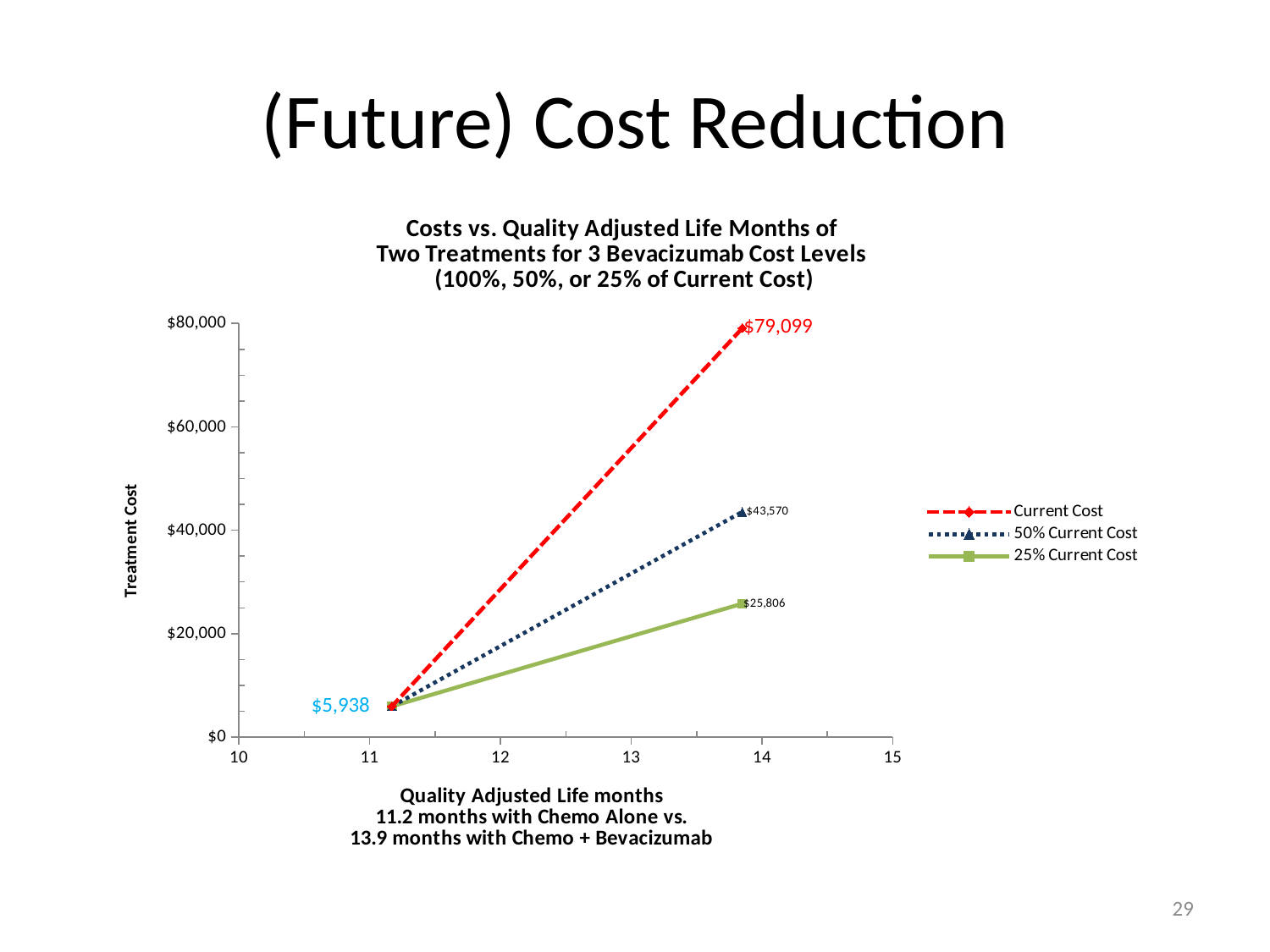
How many series does the legend list? 3 Which is larger at 13.9 months: the 50% Current Cost value or the 25% Current Cost value? 50% Current Cost Which series has the highest treatment cost at 13.9 months? Current Cost What is the treatment cost at 13.9 months for the Current Cost series? $79,099 What is the difference between the Current Cost and 50% Current Cost values at 13.9 months? $35,529 What kind of chart is shown on the slide? Line chart What is the difference between the 50% Current Cost and 25% Current Cost values at 13.9 months? $17,764 Do the treatment costs rise or fall as Quality Adjusted Life months increase? Rise Which series has the lowest treatment cost at 13.9 months? 25% Current Cost What is the treatment cost at 13.9 months for the 25% Current Cost series? $25,806 What is the treatment cost at 13.9 months for the 50% Current Cost series? $43,570 What is the treatment cost labelled at the starting point (11.2 months, Chemo Alone)? $5,938